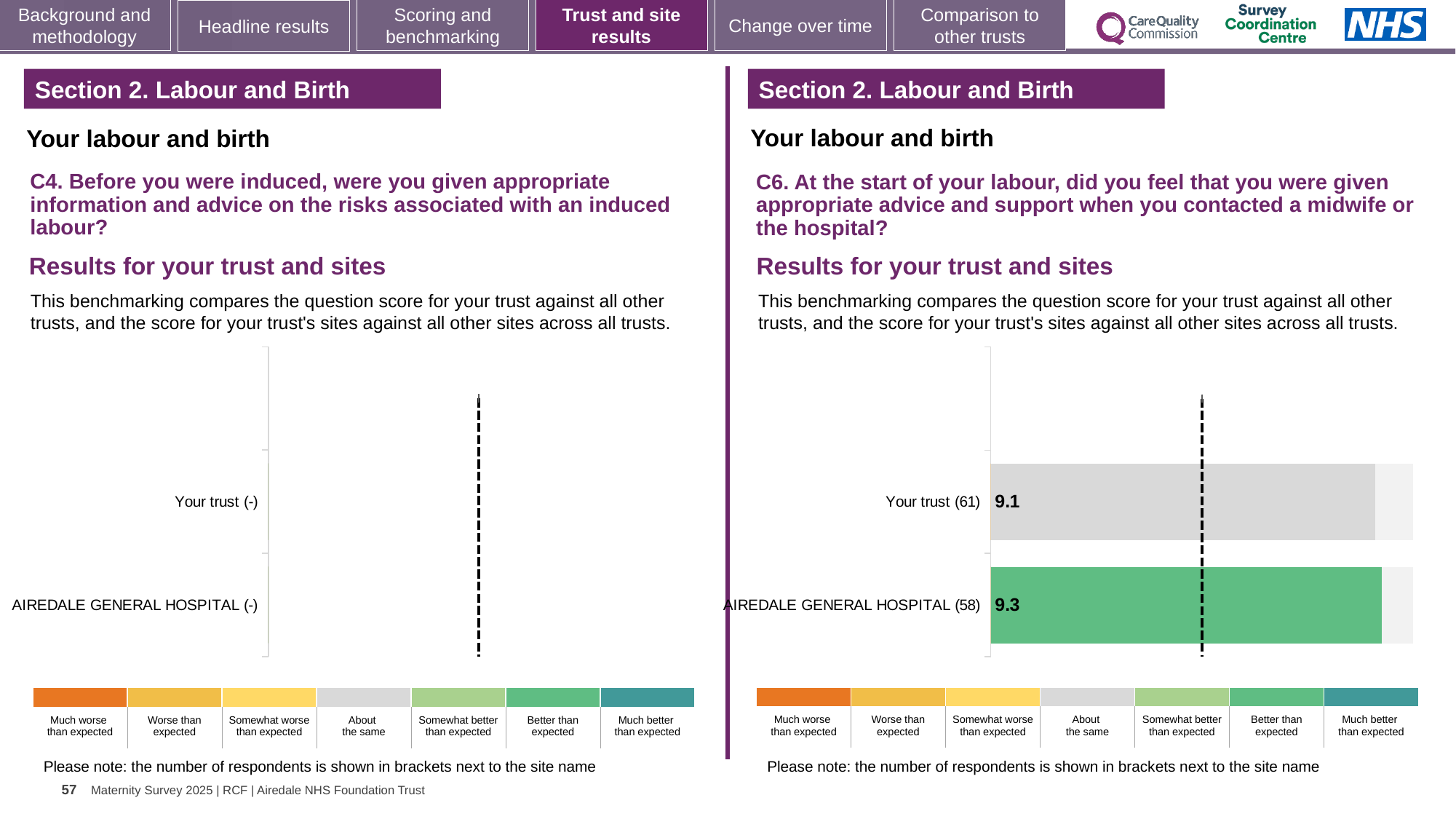
In the C6 chart on the right, what colour is the bar for AIREDALE GENERAL HOSPITAL? green In the C6 chart on the right, what is the score for Your trust? 9.1 How many categories are listed on the y axis of the C4 chart on the left? 2 In the C6 chart on the right, which category has the higher score? AIREDALE GENERAL HOSPITAL In the C6 chart on the right, how many respondents are shown in brackets for AIREDALE GENERAL HOSPITAL? 58 In the C6 chart on the right, which category has the lower score? Your trust In the C6 chart on the right, what is the score for AIREDALE GENERAL HOSPITAL? 9.3 In the C6 chart on the right, how many respondents are shown in brackets for Your trust? 61 What kind of chart is the C6 chart on the right? bar chart In the C6 chart on the right, what is the difference between the AIREDALE GENERAL HOSPITAL score and the Your trust score? 0.2 In the C6 chart on the right, is the score for AIREDALE GENERAL HOSPITAL larger or smaller than the score for Your trust? larger How many categories are plotted in the C6 chart on the right? 2